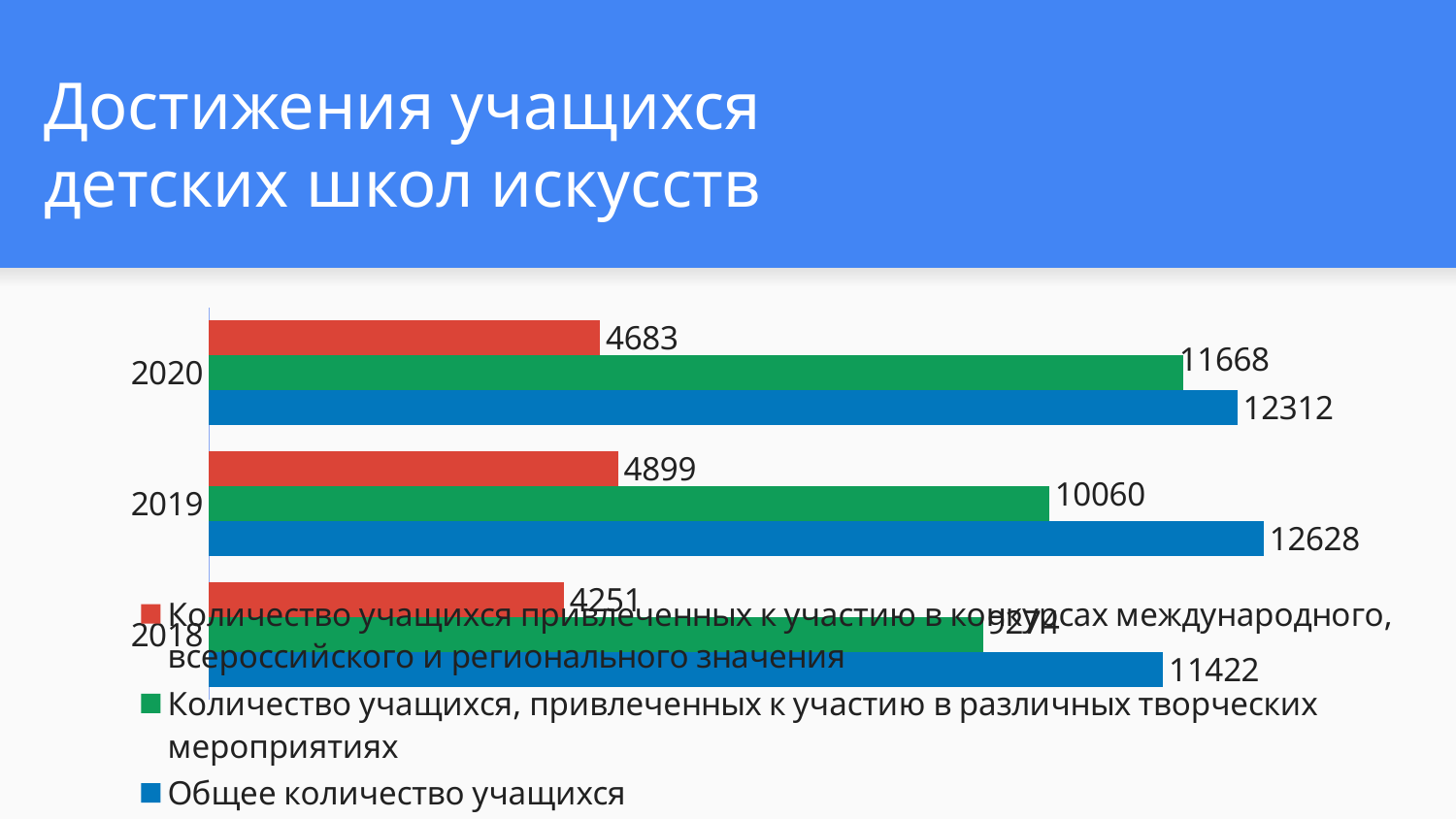
In which year was the number of students involved in competitions lowest? 2018 In which year was the total number of students highest? 2019 What is the total number of students (Общее количество учащихся) in 2019? 12628 What kind of chart is shown on the slide? bar chart How many years are shown on the chart? 3 What is the total number of students (Общее количество учащихся) in 2020? 12312 How many series does the legend list? 3 What is the total number of students (Общее количество учащихся) in 2018? 11422 How many students were involved in competitions of international, all-Russian and regional significance in 2019? 4899 How many students were involved in various creative events in 2020? 11668 Which is larger: the number of students involved in creative events in 2020 or in 2019? 2020 What is the difference between the total number of students in 2019 and in 2020? 316